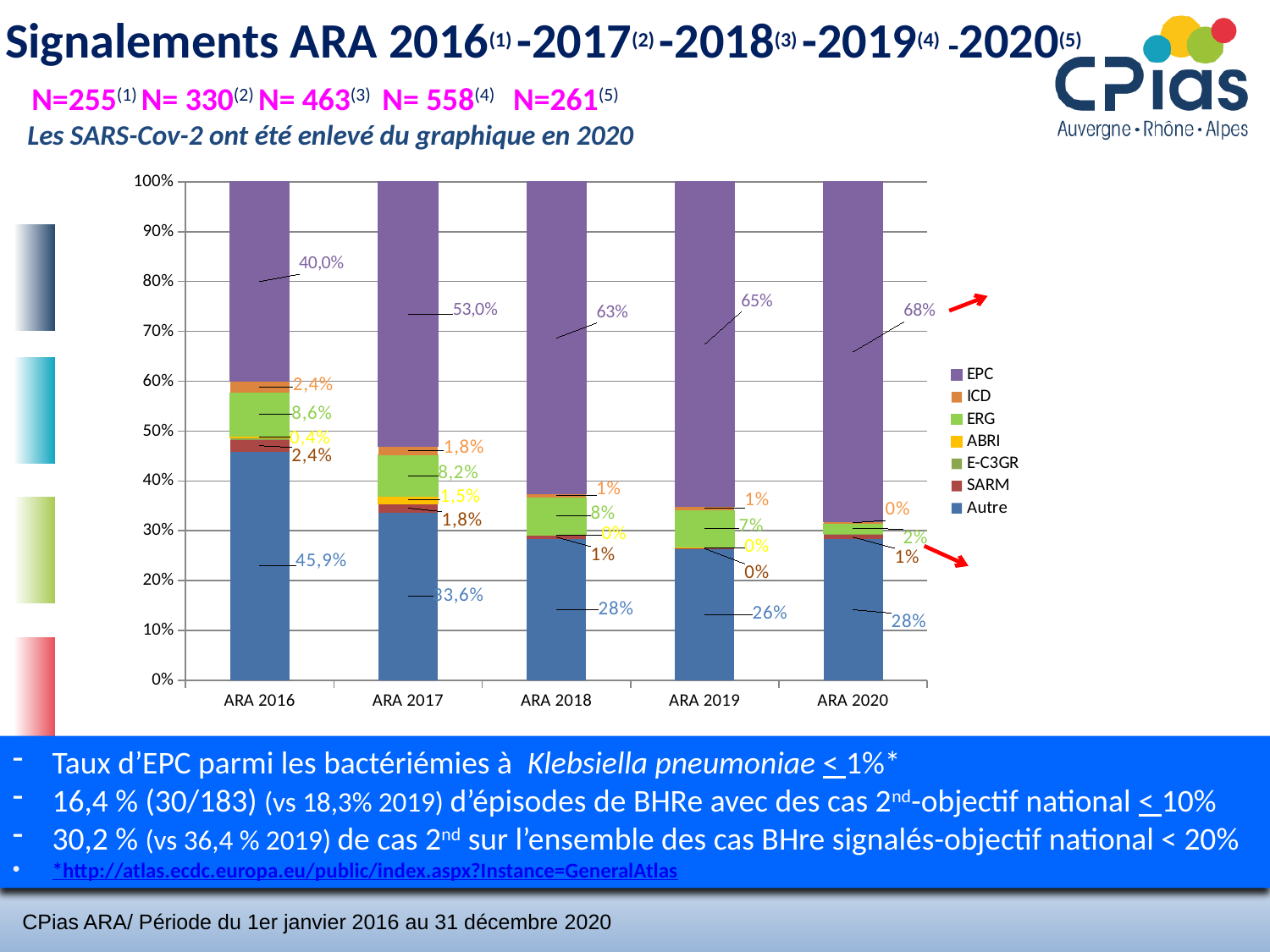
How many years (categories) are shown on the x axis? 5 What is the EPC share for ARA 2020? 68% How many series does the legend list? 7 What is the EPC share for ARA 2016? 40,0% In which year is the Autre share the lowest? ARA 2019 What is the Autre share for ARA 2017? 33,6% In which year is the EPC share the highest? ARA 2020 By how many percentage points does the EPC share in ARA 2020 exceed that in ARA 2016? 28 percentage points What kind of chart is shown? Stacked bar chart Does the EPC share rise or fall from ARA 2016 to ARA 2020? Rise What is the ERG share for ARA 2018? 8% Which is larger: the ERG share in ARA 2016 or in ARA 2020? ARA 2016